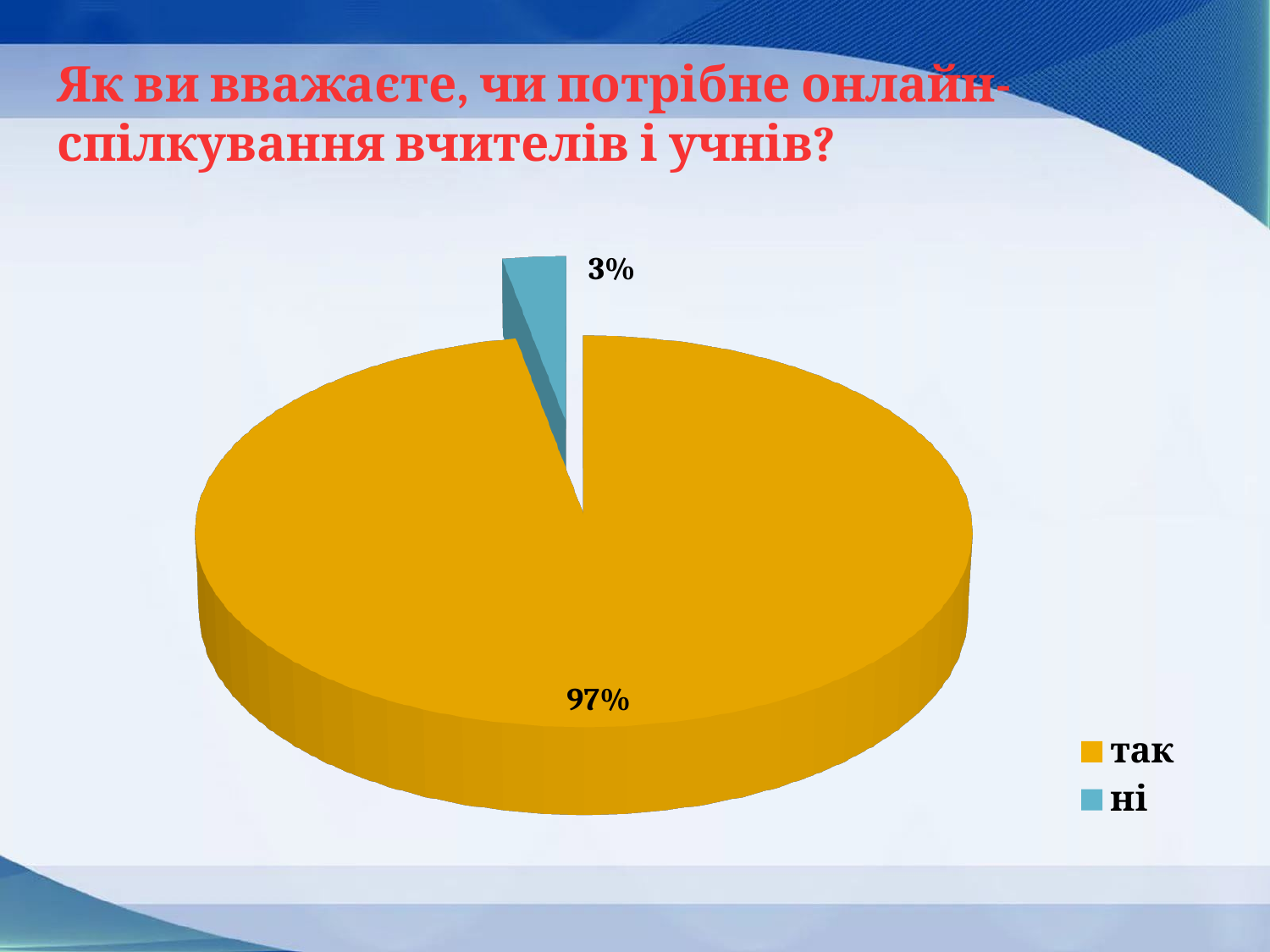
What kind of chart is shown on the slide? pie chart What colour is the "ні" slice? blue What share of the pie does the "ні" slice represent? 3% Which is larger, the "так" slice or the "ні" slice? так What colour is the "так" slice? orange What is the difference in percentage points between the "так" and "ні" slices? 94 What share of the pie does the "так" slice represent? 97% Which category has the smallest slice of the pie? ні How many categories does the pie chart show? 2 How many entries does the legend list? 2 Is the value for "так" greater or less than 50%? greater Which category has the largest slice of the pie? так